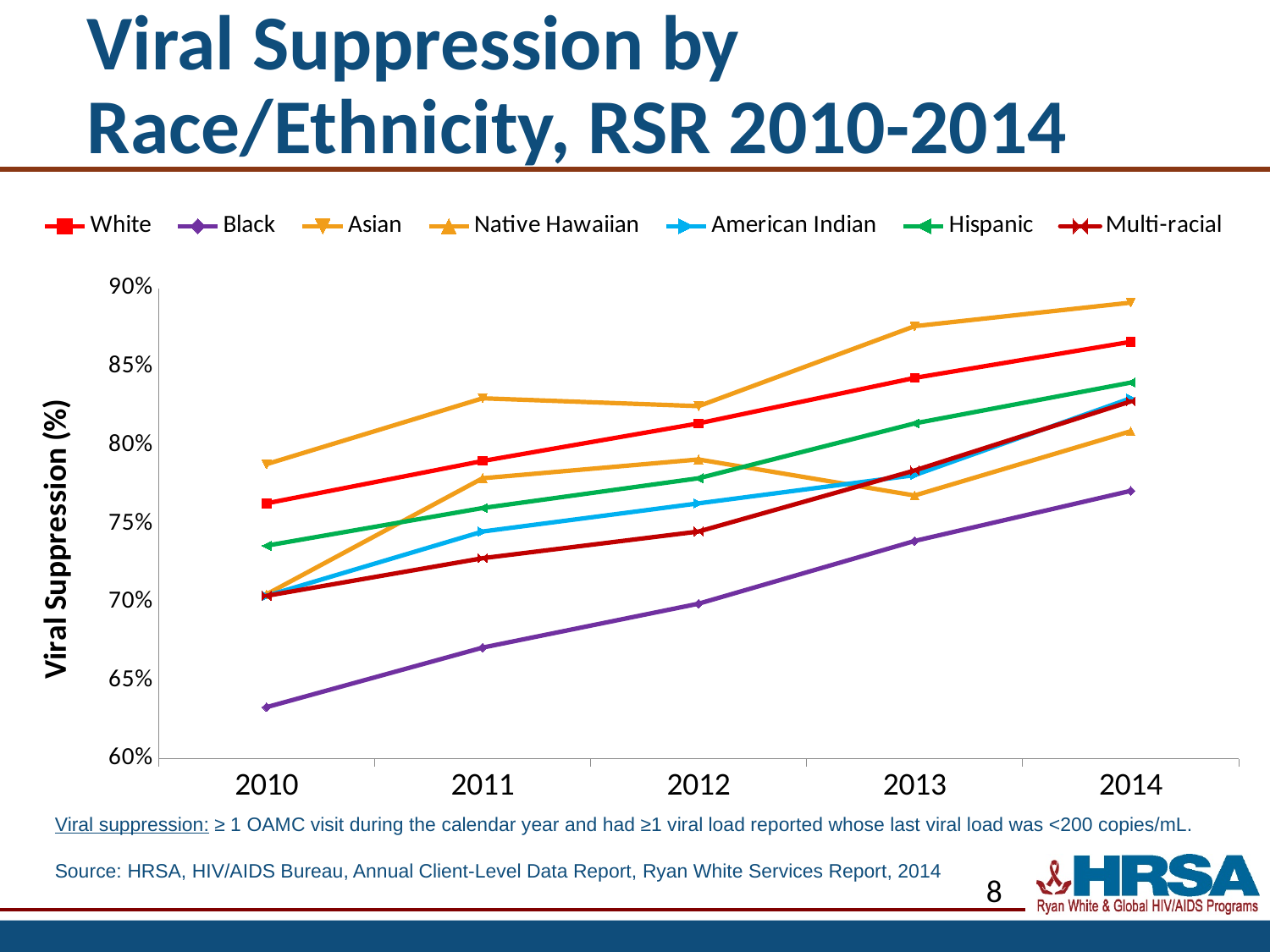
Which race/ethnicity group has the highest viral suppression in 2014? Asian Does the viral suppression for Black rise or fall from 2010 to 2014? rise What kind of chart is shown on the slide? line chart Is the value for Black in 2010 greater or less than 65%? less Which race/ethnicity group has the lowest viral suppression in 2010? Black In 2012, which is larger: the value for White or the value for Hispanic? White How many series does the legend list? 7 What is the title of the y axis? Viral Suppression (%) Is the value for White in 2014 greater or less than 85%? greater Is the value for Hispanic in 2010 greater or less than 75%? less How many years are plotted along the x axis? 5